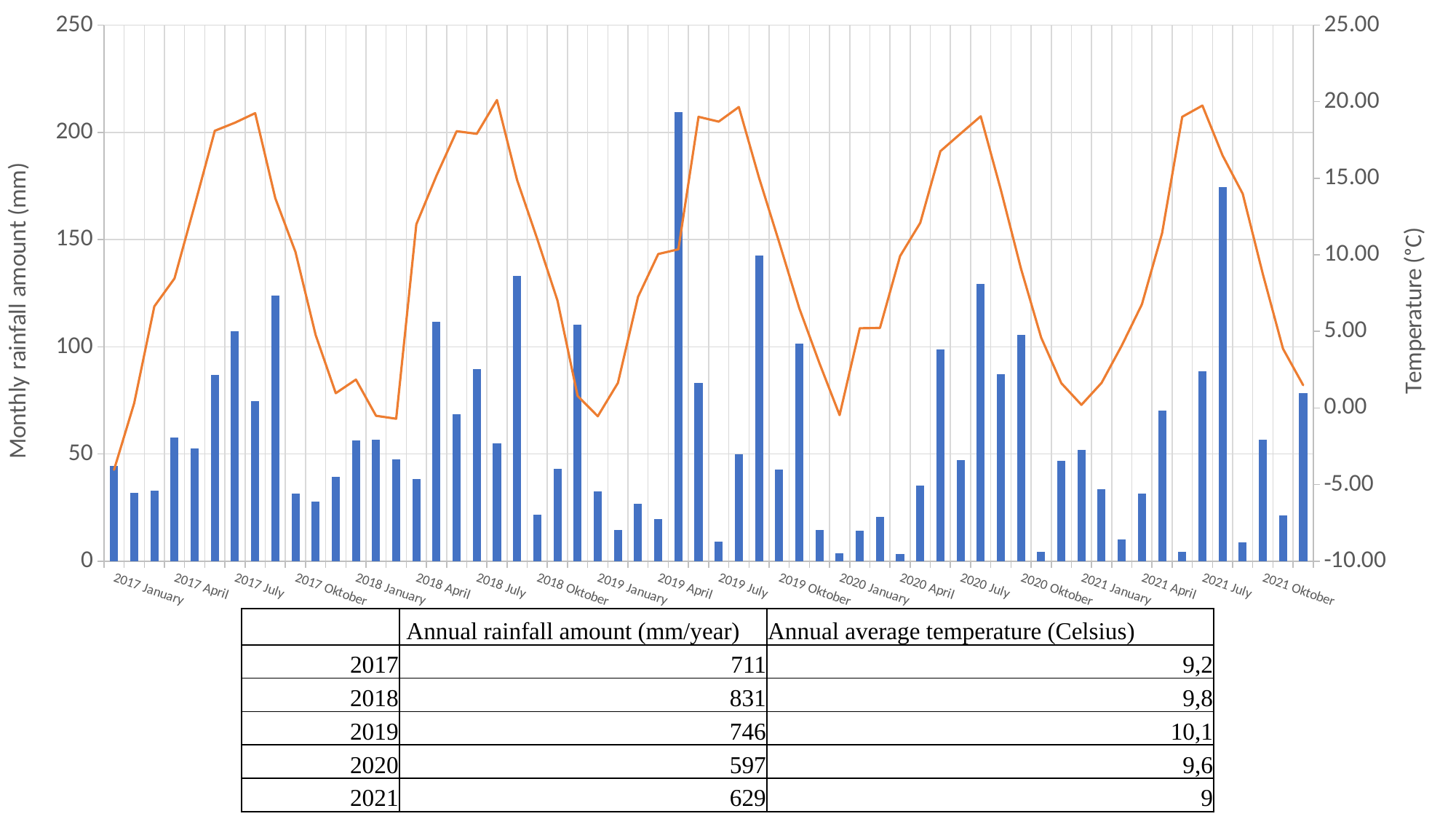
How many monthly rainfall bars are plotted in the chart? 60 What is the title of the left vertical axis of the chart? Monthly rainfall amount (mm) Is the temperature line value for 2017 July greater or less than 15.00? greater What is the title of the right vertical axis of the chart? Temperature (°C) Which has the larger monthly rainfall bar, 2020 July or 2021 July? 2021 July Is the temperature line value for 2017 January greater or less than 0.00? less What kind of chart is shown on the slide? Combined bar and line chart Within each year, does the temperature line rise or fall from January to July? rise Is the monthly rainfall bar for 2019 April greater or less than 150? less Which month has the highest monthly rainfall bar in the chart? 2019 May